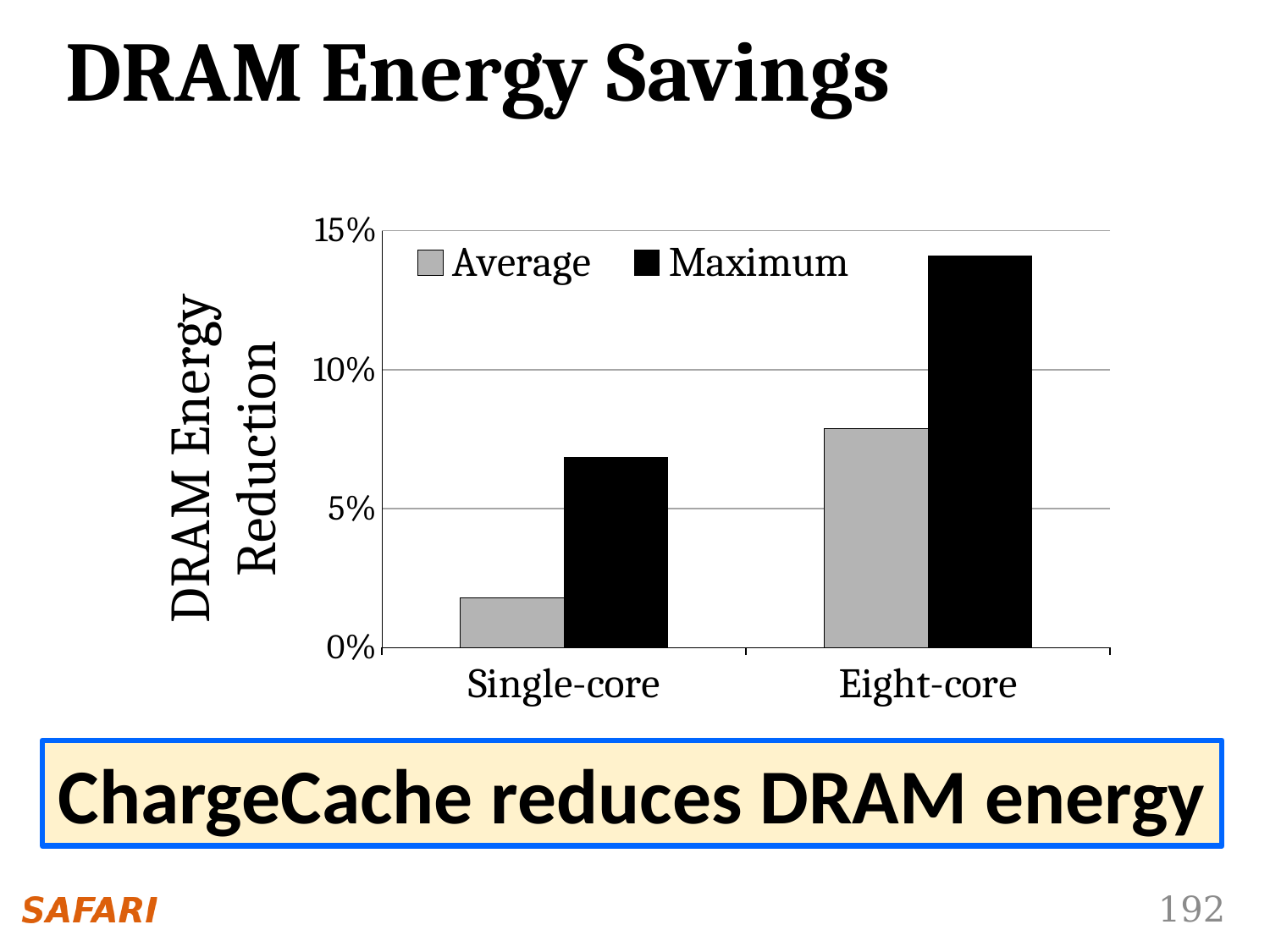
How many categories are shown on the x axis? 2 Is the Maximum value for Eight-core greater or less than 10%? greater Is the Average value for Eight-core greater or less than 10%? less Which category and series has the tallest bar? Eight-core, Maximum How many series does the legend list? 2 Is the Average value for Single-core greater or less than 5%? less Do the Average values rise or fall from Single-core to Eight-core? rise What is the label on the y axis of the chart? DRAM Energy Reduction Which is larger, the Maximum value for Single-core or the Maximum value for Eight-core? Eight-core What kind of chart is shown on the slide? bar chart Which category and series has the shortest bar? Single-core, Average